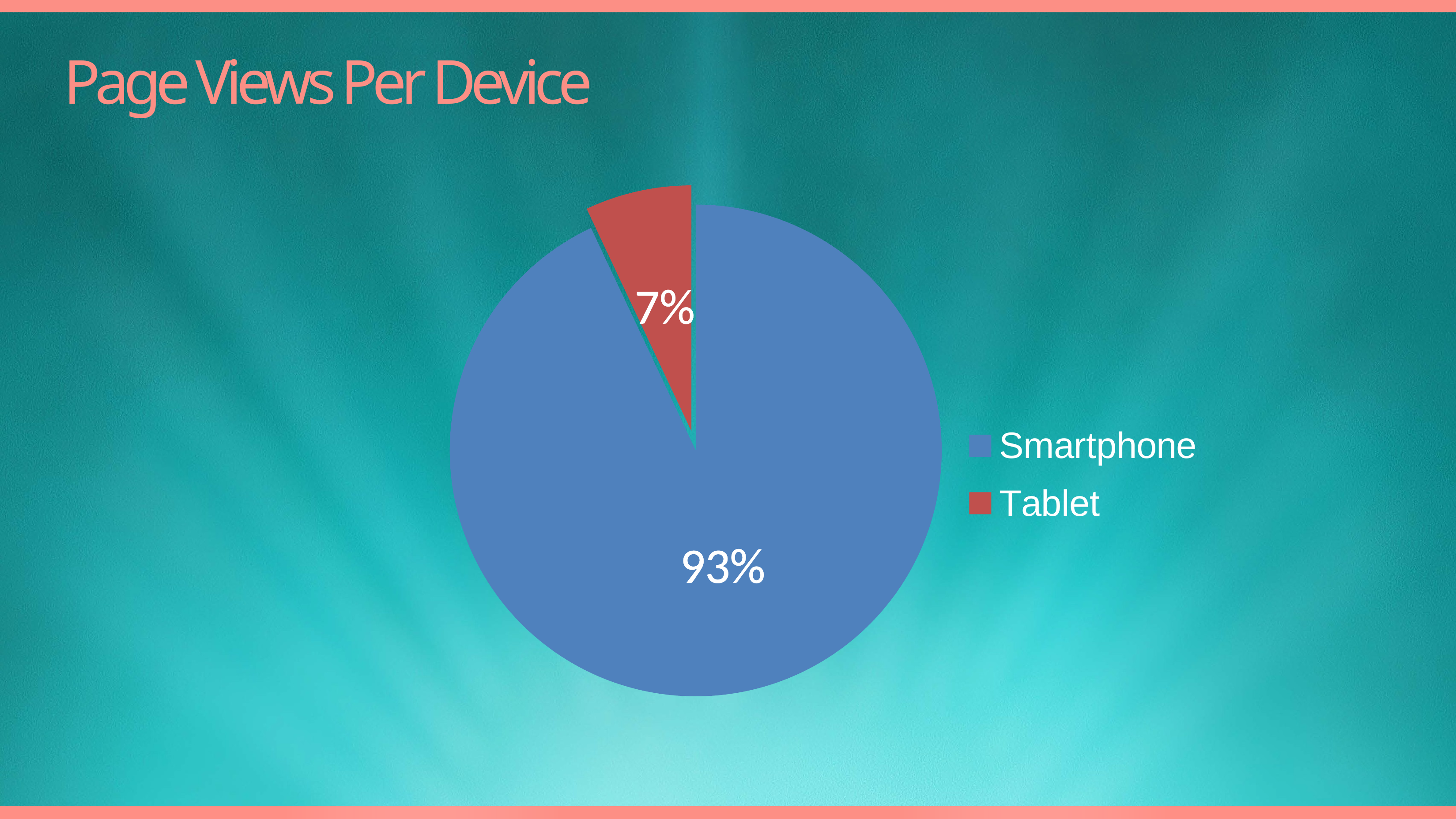
How many entries does the legend list? 2 How many slices does the pie chart have? 2 What is the difference in percentage points between the Smartphone and Tablet shares? 86 What share of page views comes from Smartphone? 93% Which device has the smallest share of page views? Tablet Which device has the largest share of page views? Smartphone What type of chart is shown on the slide? Pie chart What is the title of the slide? Page Views Per Device Which is larger, the Smartphone share or the Tablet share? Smartphone What colour is the Tablet slice? Red What share of page views comes from Tablet? 7%